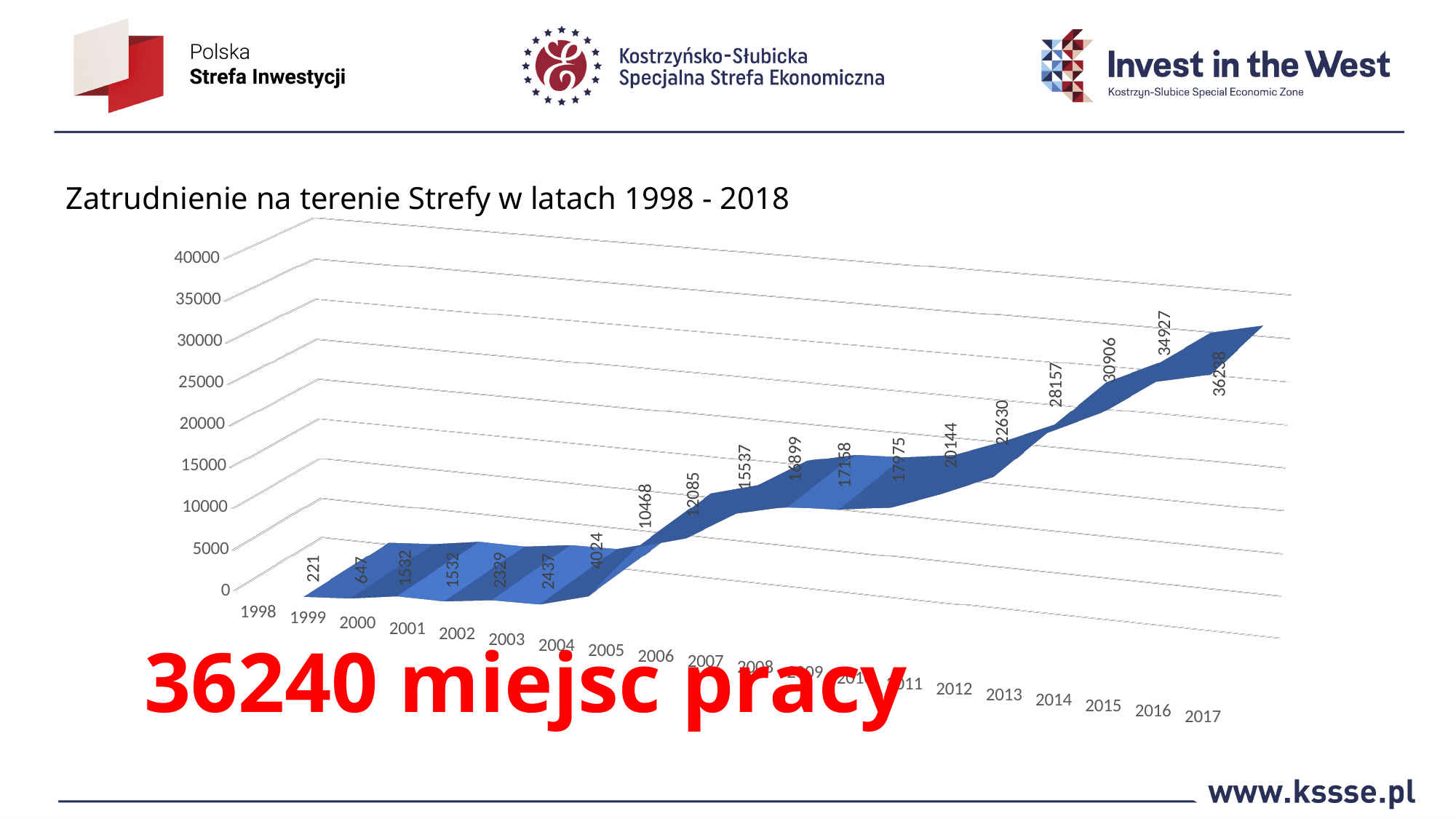
What is the lowest value labelled on the chart? 221 Which data label immediately follows the label 4024 along the x axis? 10468 What is the title of the chart? Zatrudnienie na terenie Strefy w latach 1998 - 2018 What is the difference between the labelled values 34927 and 30906? 4021 What is the difference between the labelled values 28157 and 22630? 5527 What kind of chart is shown on the slide? line chart Is the highest value on the chart greater or less than 35000? greater What does the large red text over the chart say? 36240 miejsc pracy Which labelled value is larger, 15537 or 12085? 15537 Do the employment values generally rise or fall from left to right along the x axis? rise What is the highest value labelled on the chart? 36238